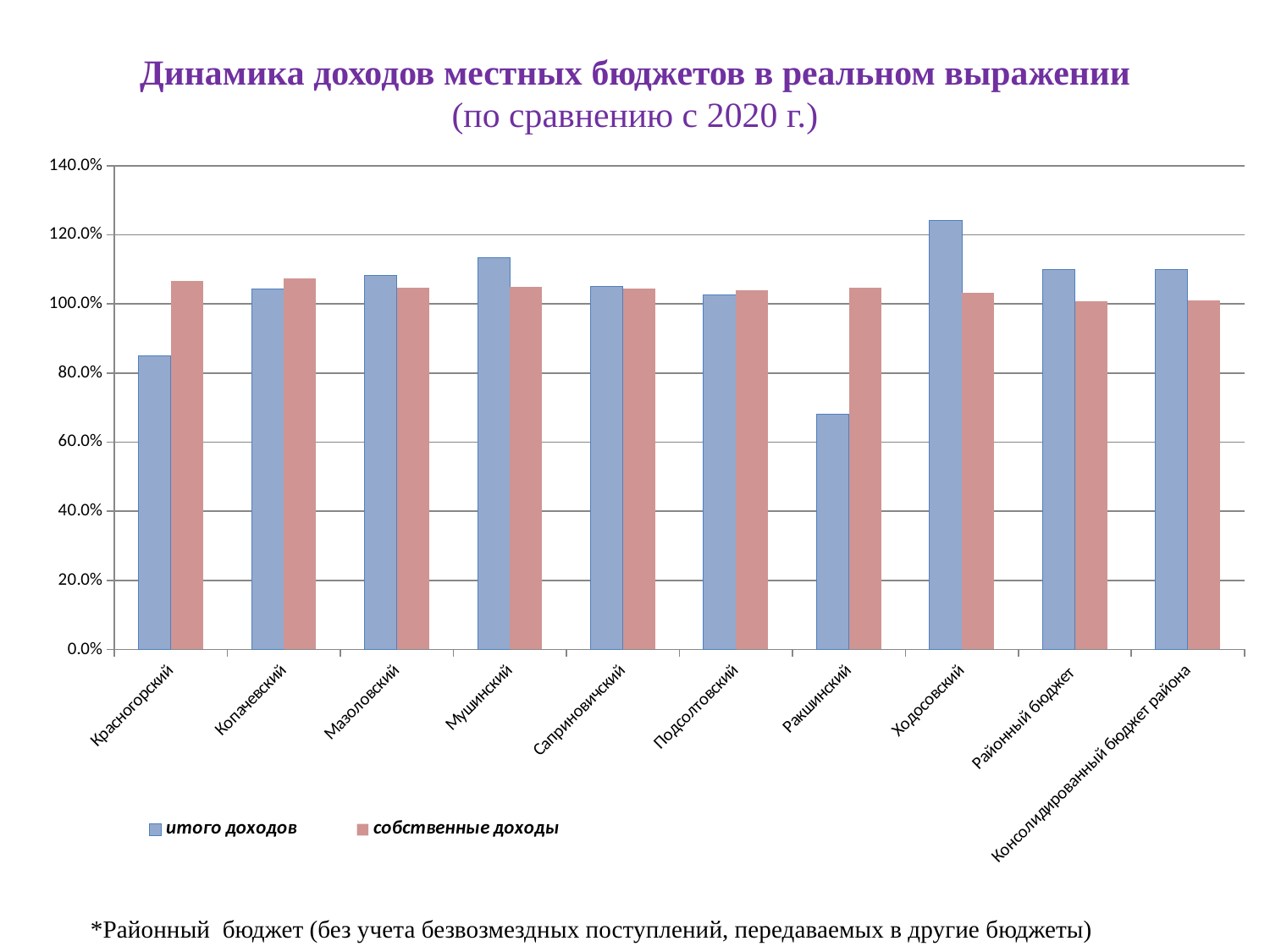
What kind of chart is shown on the slide? bar chart Is the value of итого доходов for Ходосовский greater or less than 120%? greater Is the value of итого доходов for Ракшинский greater or less than 60%? greater For Красногорский, which is larger: итого доходов or собственные доходы? собственные доходы Which category has the highest value for итого доходов? Ходосовский Which category has the lowest value for итого доходов? Ракшинский For Ракшинский, which is larger: итого доходов or собственные доходы? собственные доходы Which series is shown in blue in the legend? итого доходов How many categories are shown on the x axis? 10 For Мушинский, which is larger: итого доходов or собственные доходы? итого доходов How many series does the legend list? 2 Is the value of итого доходов for Красногорский greater or less than 100%? less